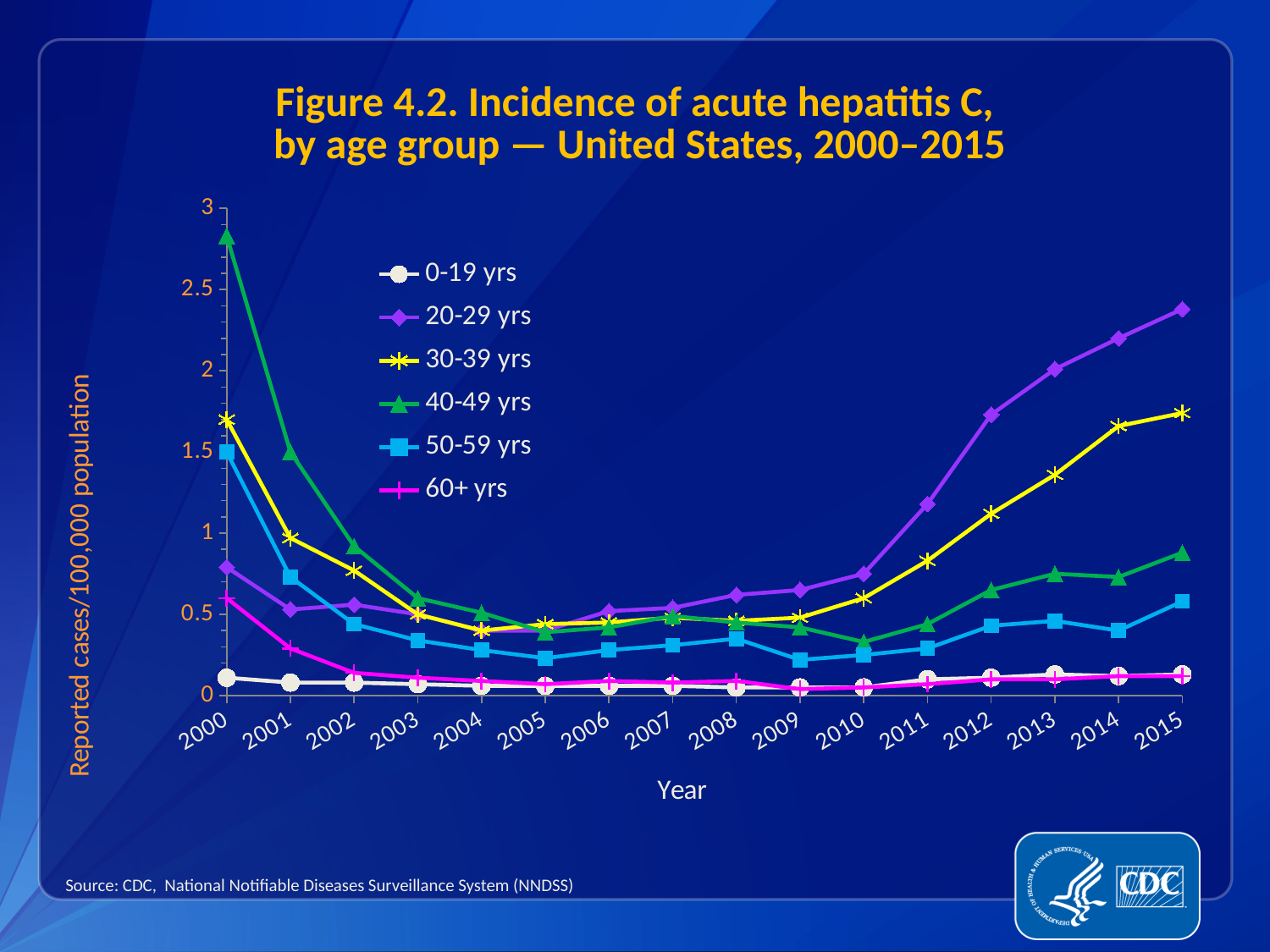
What is the label on the y axis? Reported cases/100,000 population Is the value for 0-19 yrs in 2015 greater or less than 0.5? less Which age group has the lowest incidence in 2000? 0-19 yrs How many years are plotted along the x axis? 16 Is the value for 40-49 yrs in 2000 greater or less than 2.5? greater How many age-group series does the legend list? 6 In 2015, which is larger: the value for 20-29 yrs or the value for 30-39 yrs? 20-29 yrs Is the value for 20-29 yrs in 2015 greater or less than 2? greater Which age group has the highest incidence in 2015? 20-29 yrs Does the 40-49 yrs line rise or fall from 2000 to 2005? fall Which age group has the highest incidence in 2000? 40-49 yrs What kind of chart is shown on the slide? line chart